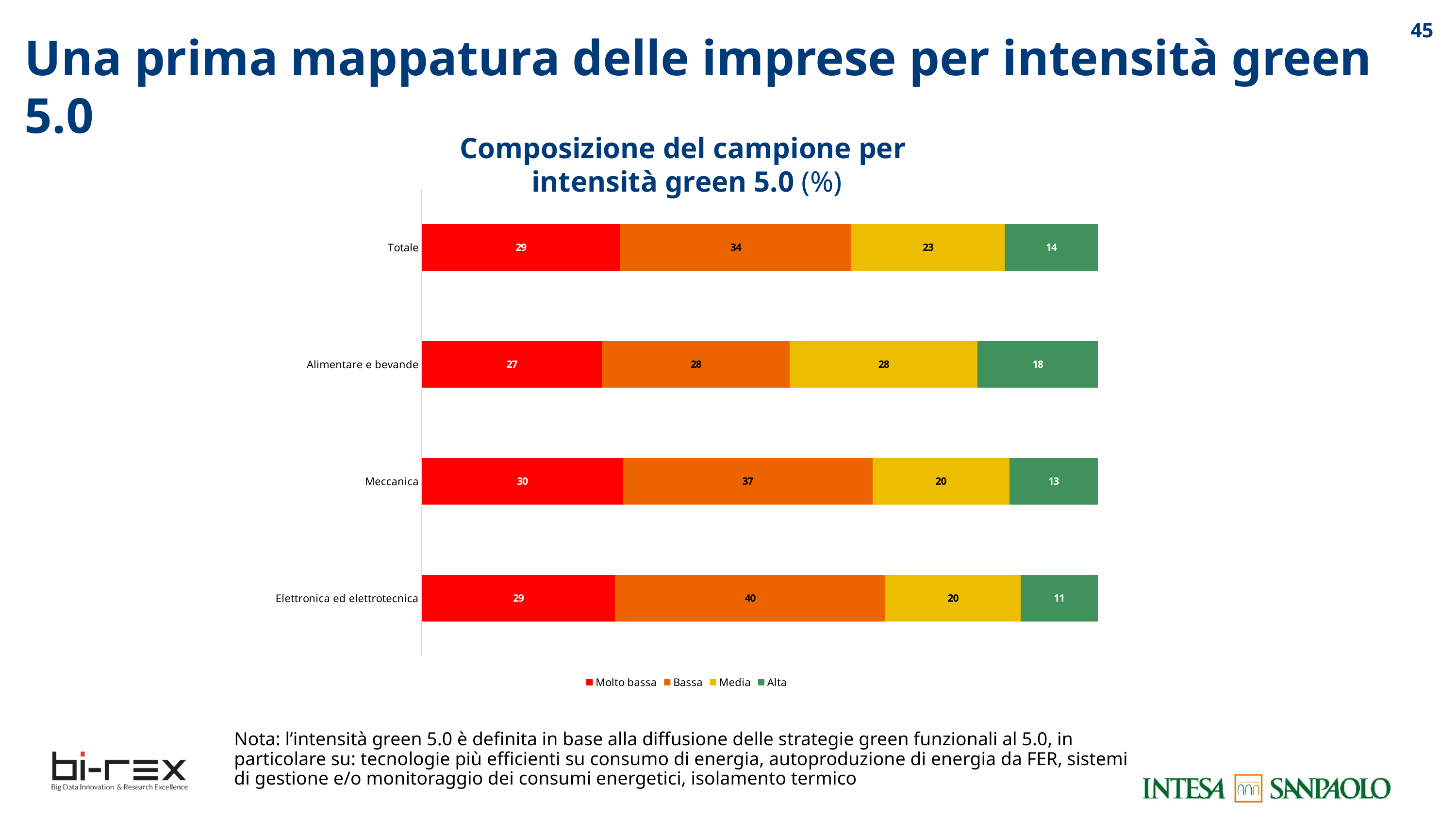
What is the value of "Molto bassa" for Totale? 29 How many categories are shown on the chart? 4 How many series does the legend list? 4 What type of chart is shown on the slide? Stacked bar chart What is the difference between the "Bassa" value for Elettronica ed elettrotecnica and the "Bassa" value for Totale? 6 What is the total of the stacked bar for Meccanica? 100 Which category has the highest value for "Bassa"? Elettronica ed elettrotecnica Which category has the lowest value for "Alta"? Elettronica ed elettrotecnica What is the value of "Alta" for Alimentare e bevande? 18 Which is larger: the "Media" value for Alimentare e bevande or the "Media" value for Meccanica? Alimentare e bevande What is the value of "Media" for Elettronica ed elettrotecnica? 20 What is the value of "Bassa" for Meccanica? 37